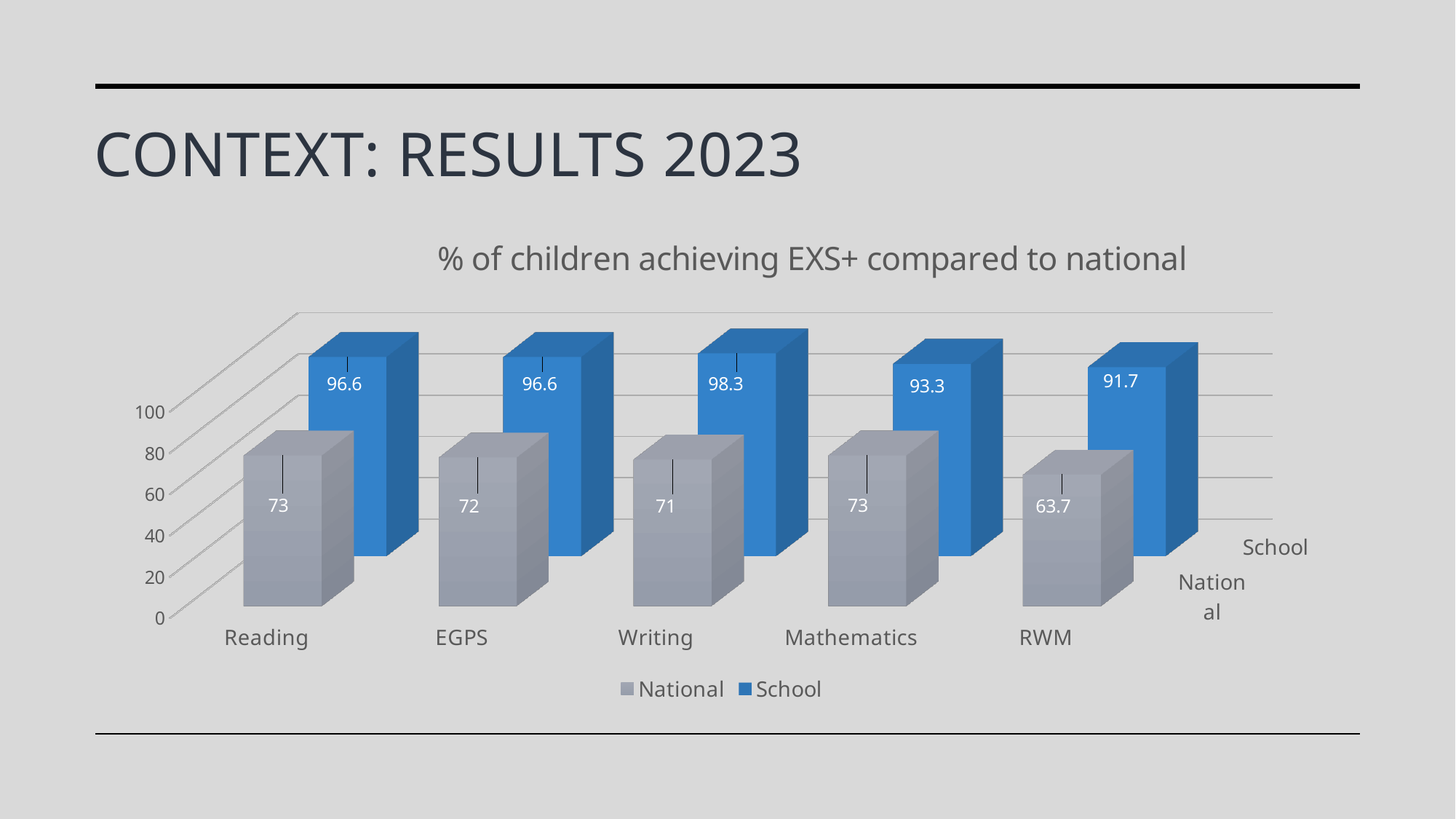
How many series does the legend list? 2 Which is larger, the School value for RWM or the National value for Reading? School value for RWM What is the National value for RWM? 63.7 Which category has the highest School value? Writing Which category has the lowest National value? RWM What is the School value for Mathematics? 93.3 What is the difference between the School and National values for Reading? 23.6 What kind of chart is shown on the slide? Bar chart What is the National value for EGPS? 72 What is the School value for Writing? 98.3 What is the title of the chart? % of children achieving EXS+ compared to national How many categories are shown on the x axis? 5